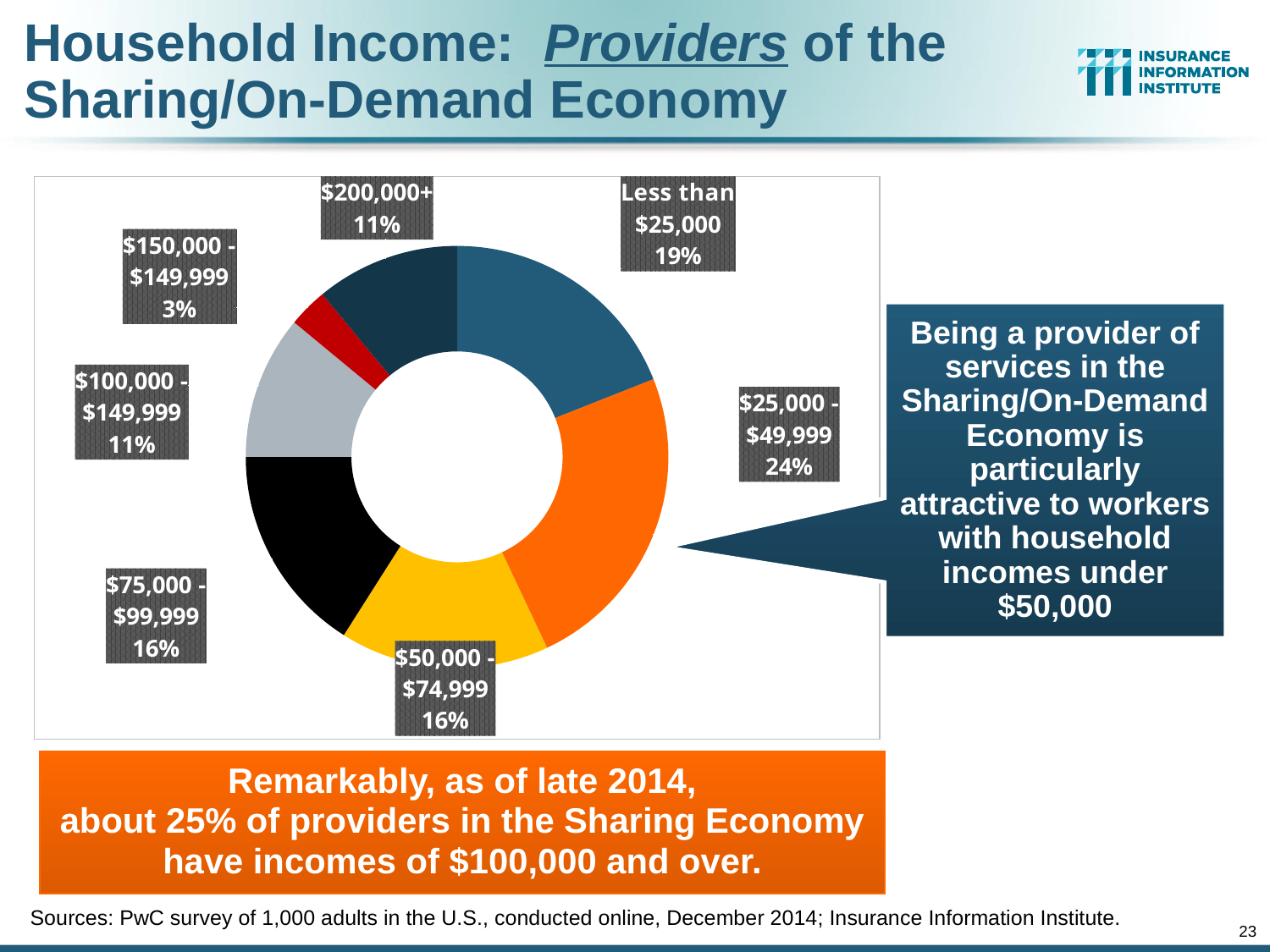
What share of providers have household incomes of $200,000+? 11% Which is larger: the share for $100,000 - $149,999 or the share for $75,000 - $99,999? $75,000 - $99,999 How many income brackets are shown in the chart? 7 What is the combined share of providers with household incomes under $50,000? 43% What colour is the slice for the $25,000 - $49,999 bracket? Orange What percentage of providers fall in the $25,000 - $49,999 income bracket? 24% What share of providers have household incomes of less than $25,000? 19% Which income bracket has the smallest share of providers? $150,000 - $149,999 How many percentage points larger is the $25,000 - $49,999 share than the Less than $25,000 share? 5 Which income bracket has the largest share of providers? $25,000 - $49,999 What percentage is shown for the $75,000 - $99,999 bracket? 16% What type of chart is used to show the household income distribution? Pie chart (donut)